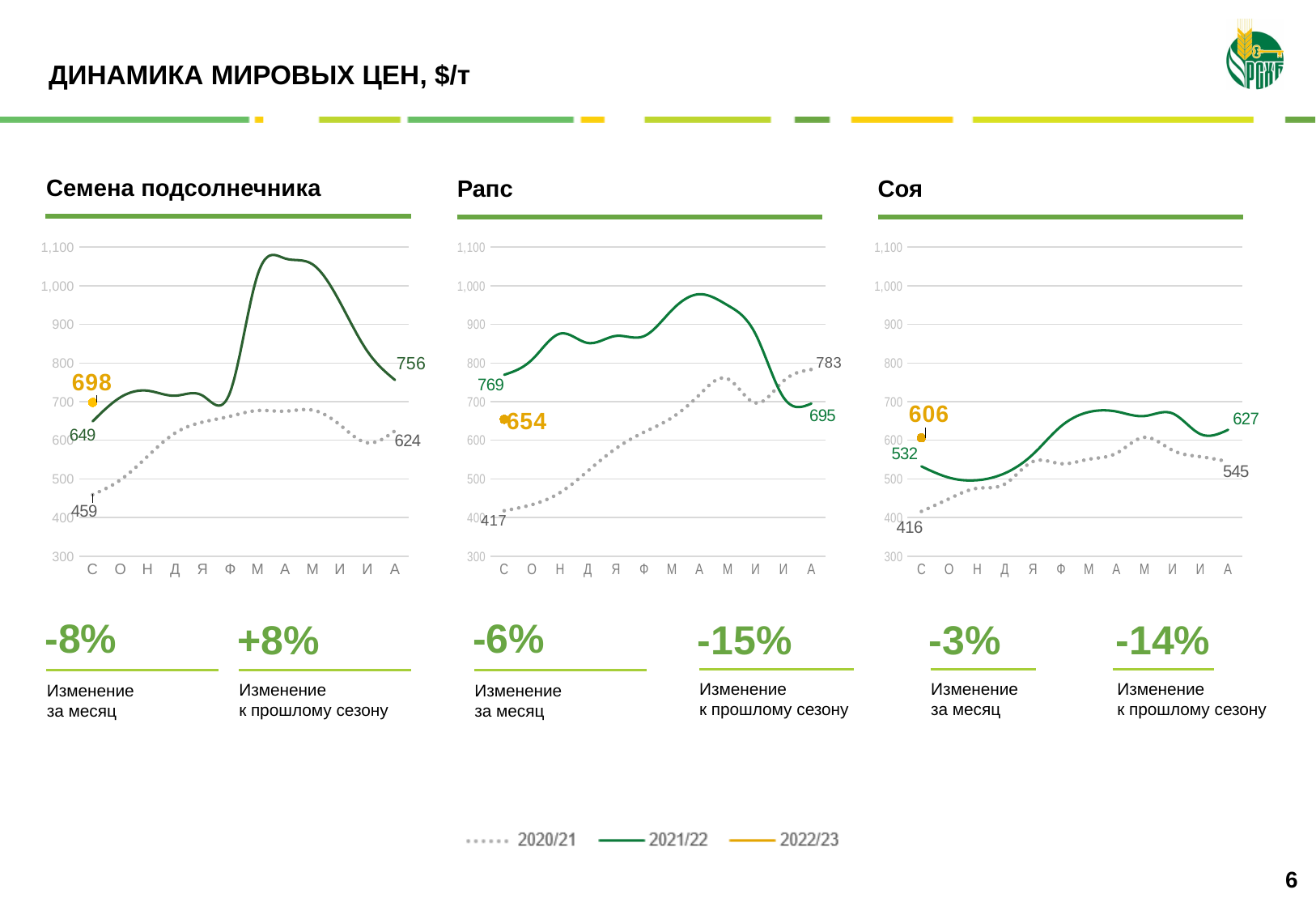
On the Рапс chart, which is larger in August: the 2020/21 value (783) or the 2021/22 value (695)? 2020/21 On the Семена подсолнечника chart, what is the difference between the August values of the 2021/22 series (756) and the 2020/21 series (624)? 132 On the Соя chart, is the peak of the 2021/22 series greater or less than 700? less How many series does the legend list? 3 On the Рапс chart, what is the August value of the 2020/21 series? 783 What type of chart is used for Семена подсолнечника? line chart On the Семена подсолнечника chart, what is the last labelled value of the 2021/22 series (August)? 756 On the Соя chart, what is the difference between the September values of the 2021/22 series (532) and the 2020/21 series (416)? 116 On the Соя chart, what is the value of the 2022/23 series in September? 606 On the Семена подсолнечника chart, what is the value of the 2022/23 series in September? 698 On the Рапс chart, what is the September value of the 2021/22 series? 769 On the Рапс chart, does the 2020/21 series generally rise or fall from September to August? rise